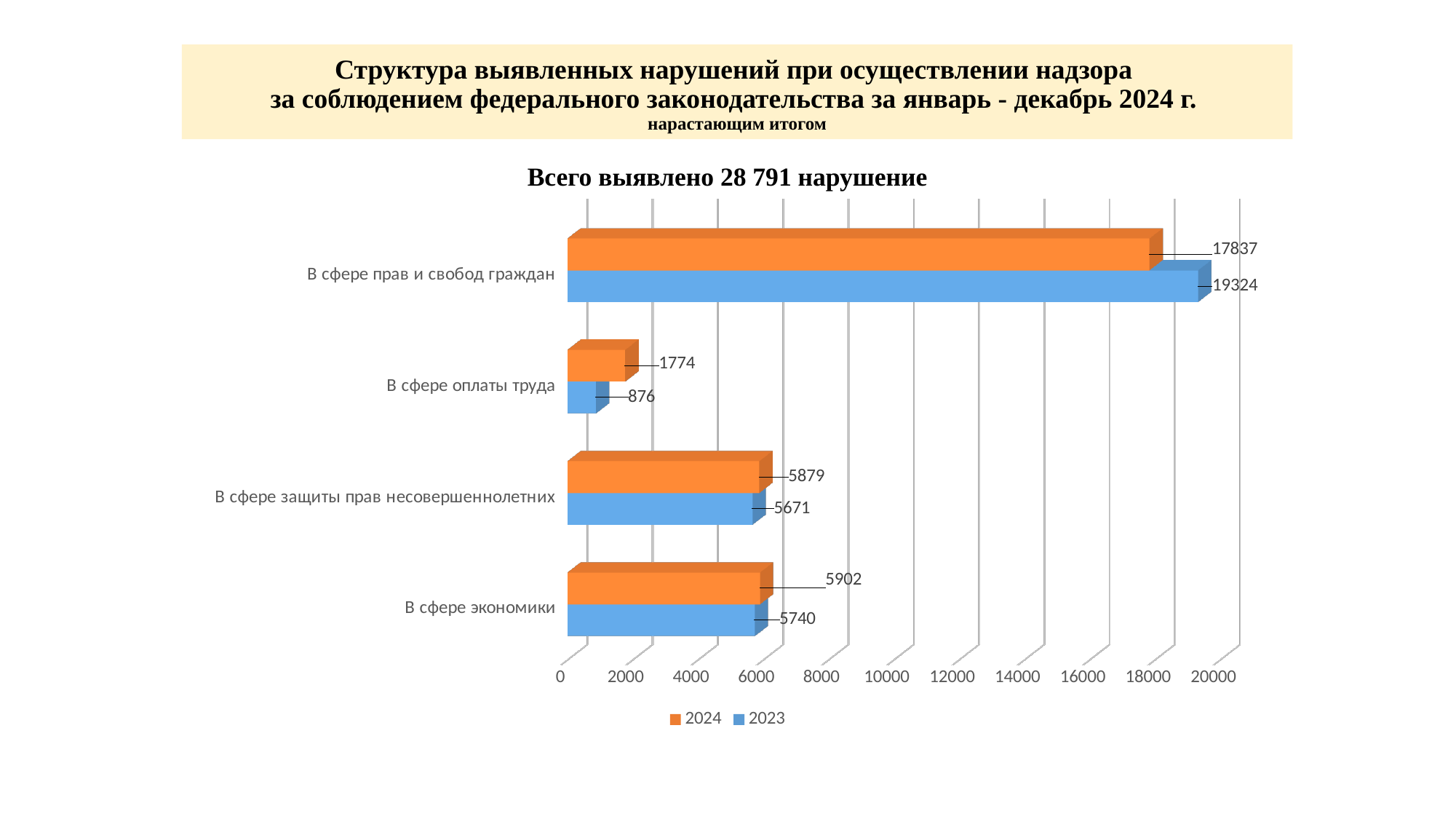
What type of chart is shown on the slide? Bar chart Which category has the lowest 2023 value? В сфере оплаты труда What is the 2023 value for 'В сфере оплаты труда'? 876 Which category has the highest 2024 value? В сфере прав и свобод граждан What is the 2024 value for 'В сфере экономики'? 5902 What is the 2024 value for 'В сфере прав и свобод граждан'? 17837 What is the 2023 value for 'В сфере защиты прав несовершеннолетних'? 5671 What is the difference between the 2024 and 2023 values for 'В сфере оплаты труда'? 898 How many series does the legend list? 2 For 'В сфере оплаты труда', which year has the larger value, 2024 or 2023? 2024 What is the difference between the 2023 and 2024 values for 'В сфере прав и свобод граждан'? 1487 How many categories are shown on the chart? 4